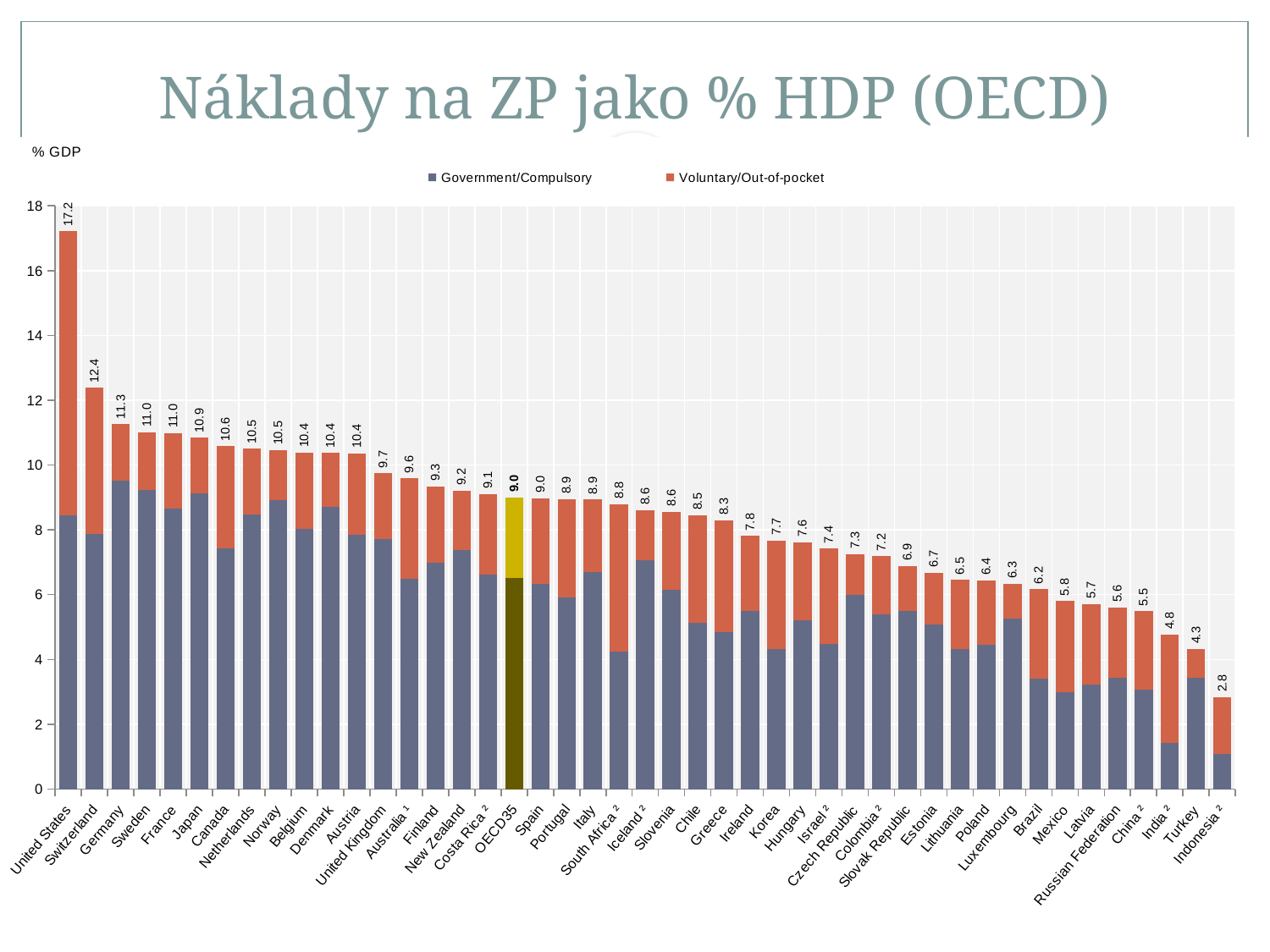
Which country has the lowest total health expenditure as % of GDP? Indonesia Which country has the highest total health expenditure as % of GDP? United States What is the total value shown for the United States? 17.2 What is the total value shown for the Czech Republic? 7.3 Is the Government/Compulsory value for India greater or less than 2? less What is the total value shown for OECD35? 9.0 Which has a larger total value, Germany or Japan? Germany What is the difference between the total values for the United States and Switzerland? 4.8 What kind of chart is shown on the slide? Stacked bar chart How many series does the legend list? 2 Do the total values rise or fall from left to right along the x axis? Fall Is the Government/Compulsory value for Germany greater or less than 8? greater